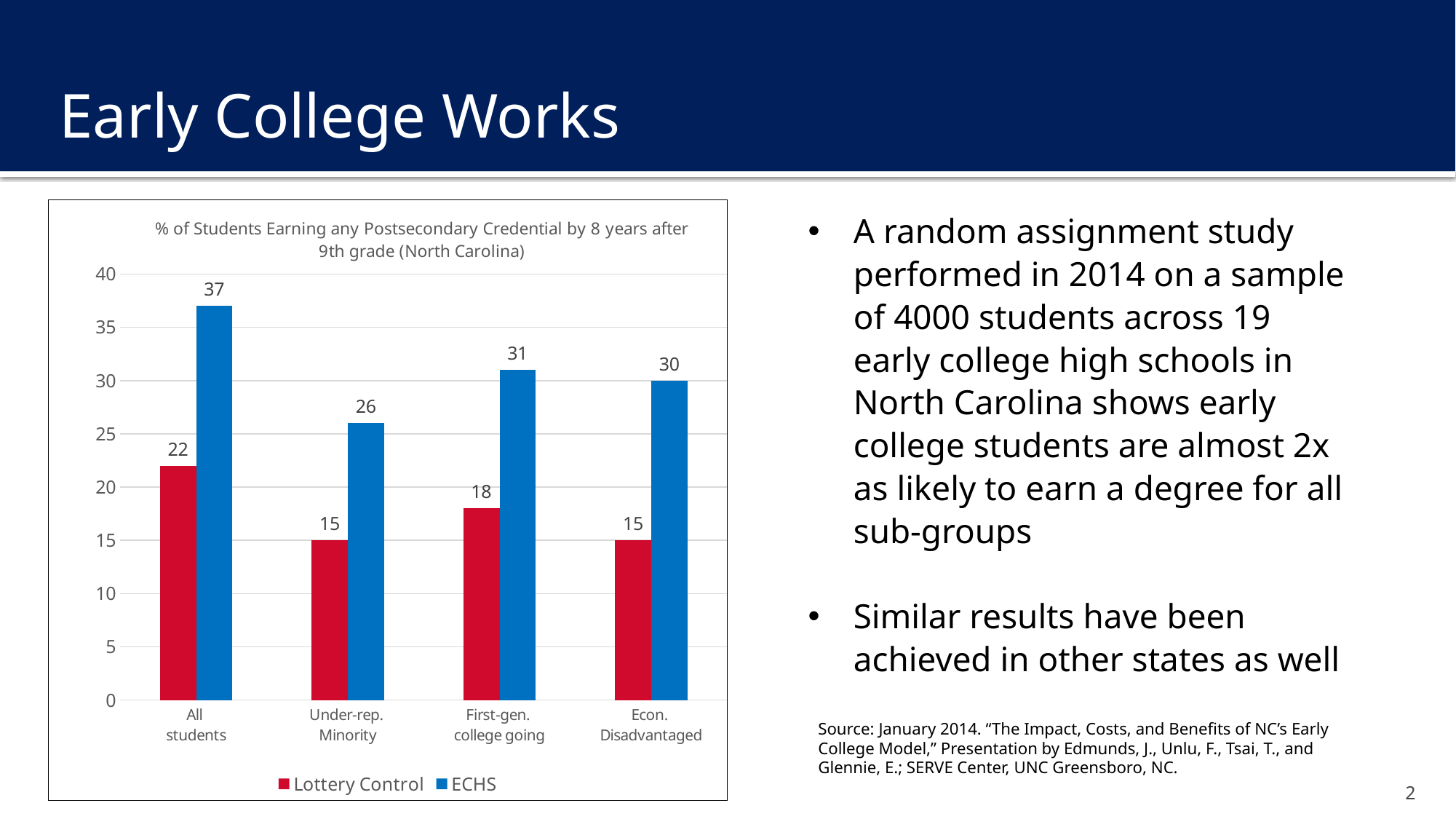
What is the difference between the ECHS and Lottery Control values for Under-rep. Minority? 11 Which colour represents the ECHS series in the legend? Blue What is the ECHS value for All students? 37 What kind of chart is shown on the slide? Bar chart How many categories are shown on the x axis? 4 What is the Lottery Control value for First-gen. college going students? 18 Which category has the lowest ECHS value? Under-rep. Minority What is the ECHS value for Econ. Disadvantaged students? 30 Which category has the highest ECHS value? All students How many series does the legend list? 2 Which is larger for Econ. Disadvantaged: the Lottery Control value or the ECHS value? ECHS What is the title of the chart? % of Students Earning any Postsecondary Credential by 8 years after 9th grade (North Carolina)